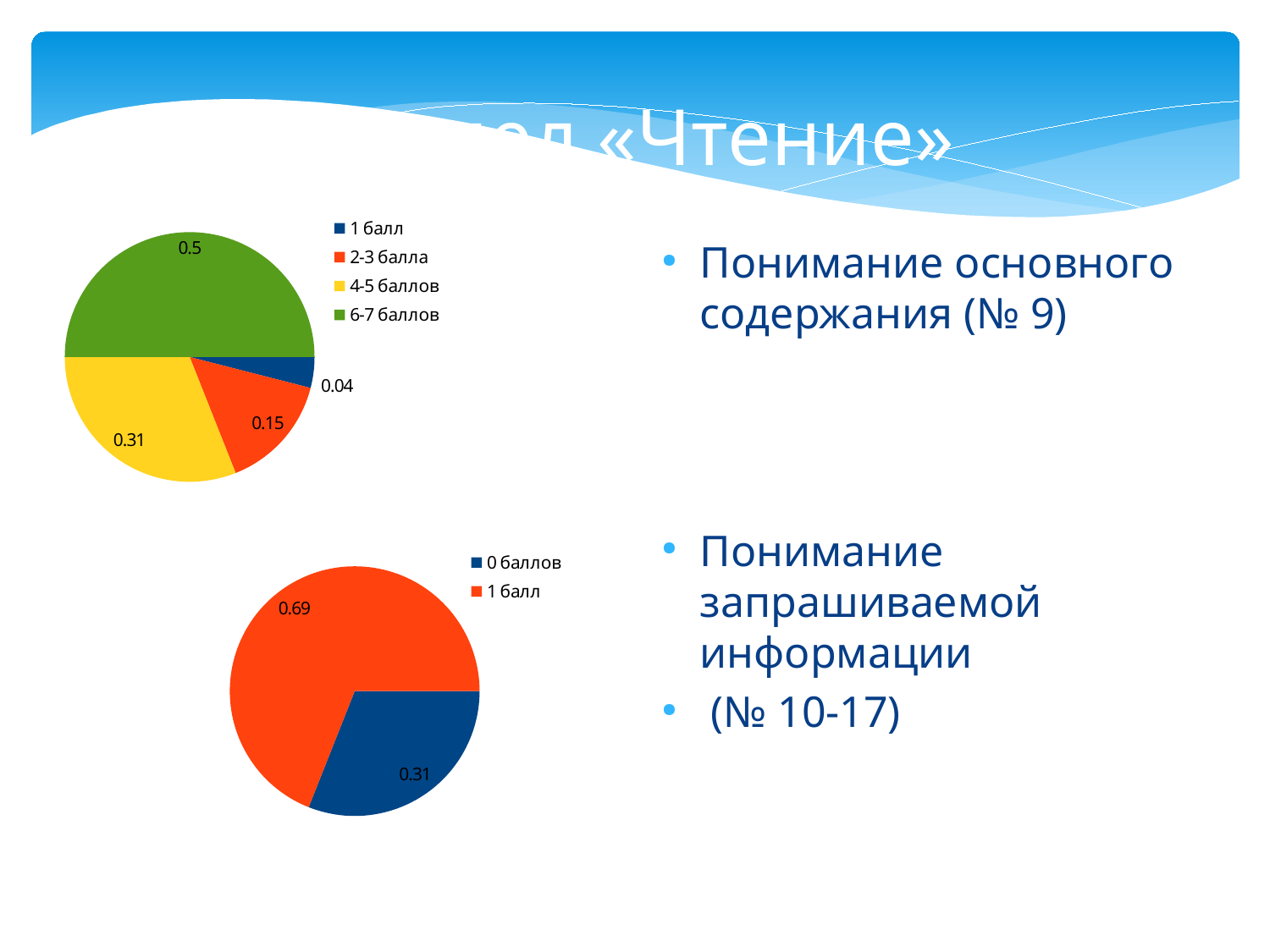
In the top pie chart, how many categories does the legend list? 4 What type of chart is the top chart on the slide? Pie chart In the top pie chart, what is the difference between the values for "4-5 баллов" and "2-3 балла"? 0.16 In the top pie chart, what is the value for the "6-7 баллов" slice? 0.5 In the top pie chart, what is the value for the "1 балл" slice? 0.04 In the bottom pie chart, which is larger, "0 баллов" or "1 балл"? 1 балл In the bottom pie chart, what is the value for the "0 баллов" slice? 0.31 In the top pie chart, what is the value for the "4-5 баллов" slice? 0.31 In the top pie chart, which category has the smallest slice? 1 балл In the top pie chart, which category has the largest slice? 6-7 баллов In the bottom pie chart, what colour is the "0 баллов" slice? Blue In the bottom pie chart, what is the value for the "1 балл" slice? 0.69